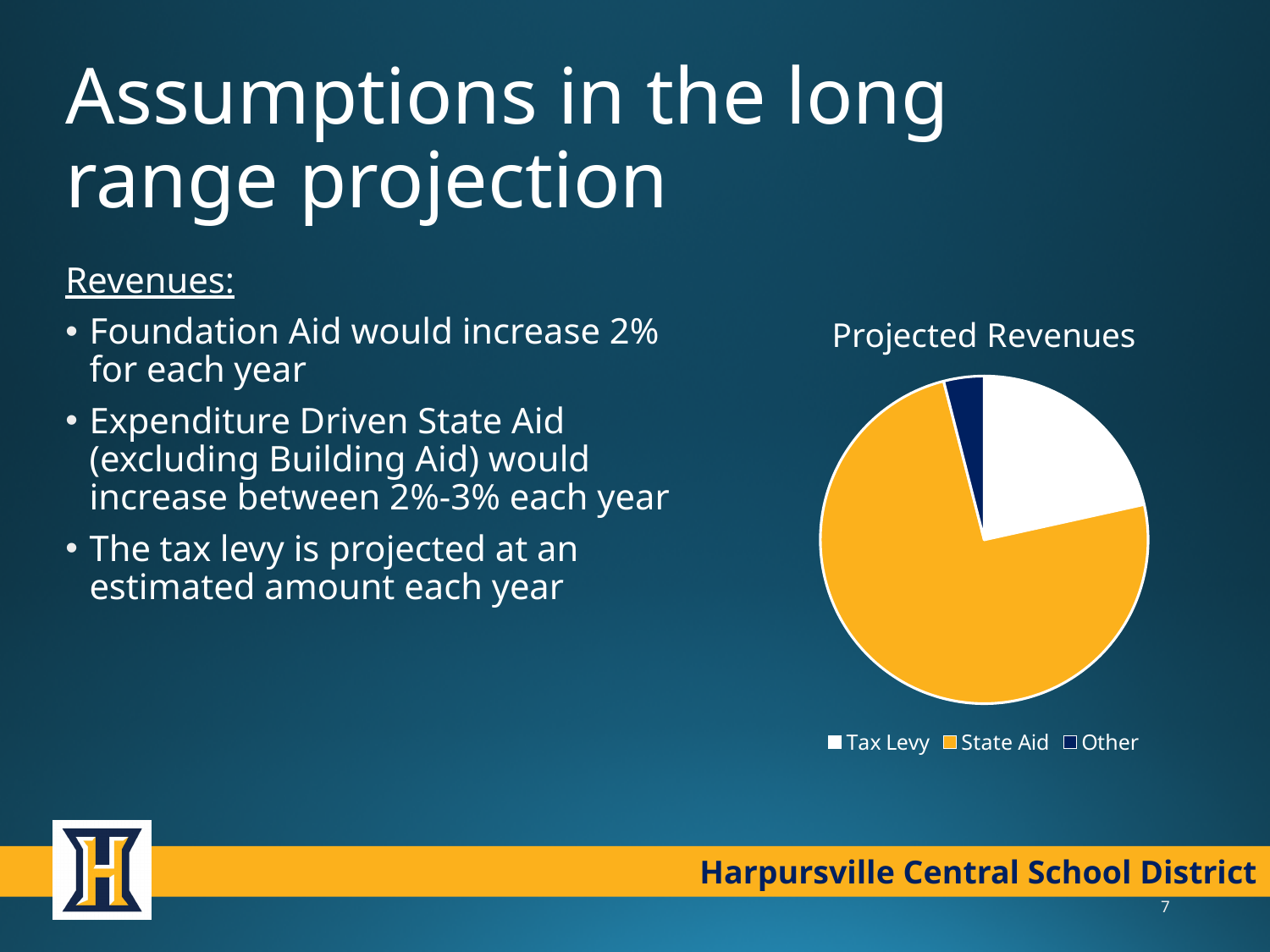
In the Projected Revenues pie chart, which is larger: Other or Tax Levy? Other Which categories are listed in the legend of the Projected Revenues chart? Tax Levy, State Aid, Other Which colour represents State Aid in the Projected Revenues pie chart? Orange How many entries does the legend of the Projected Revenues chart list? 3 In the Projected Revenues pie chart, which is larger: State Aid or Other? State Aid Which category has the largest slice in the Projected Revenues pie chart? State Aid What kind of chart is shown on the slide? Pie chart Which category has the smallest slice in the Projected Revenues pie chart? Tax Levy What is the title of the chart on the slide? Projected Revenues How many slices does the Projected Revenues pie chart have? 3